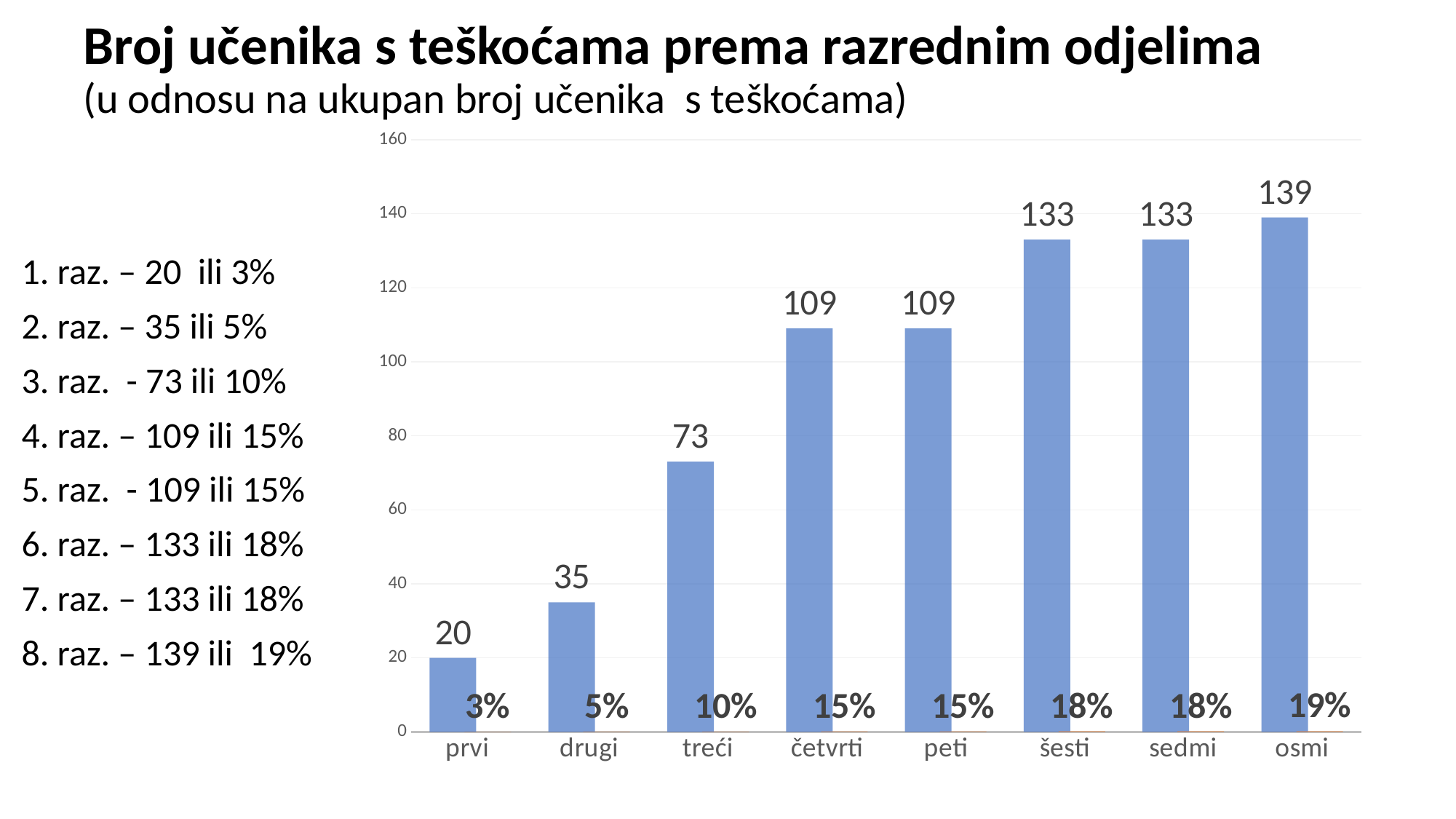
Which category has the highest value? osmi Is the value for šesti greater or less than 120? greater What percentage is shown for drugi? 5% What is the title of the chart? Broj učenika s teškoćama prema razrednim odjelima What is the difference between the values for četvrti and drugi? 74 What kind of chart is this? bar chart Which is larger, the value for treći or the value for peti? peti Which category has the lowest value? prvi Do the values generally rise or fall from prvi to osmi? rise What is the value for osmi? 139 What is the value for treći? 73 How many categories are shown on the x axis? 8